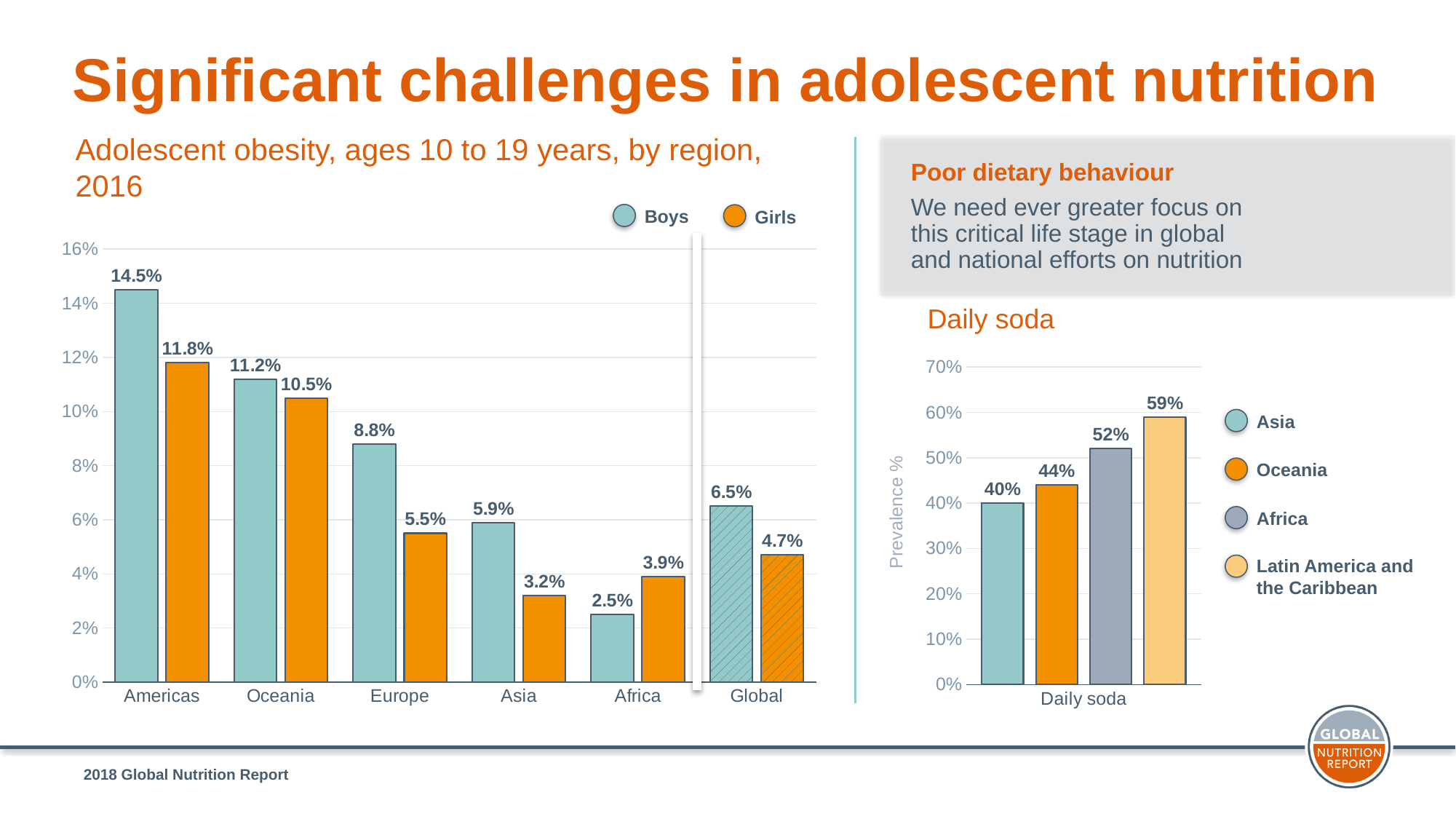
In the 'Adolescent obesity, ages 10 to 19 years, by region, 2016' chart, which is larger in Africa, Boys or Girls? Girls In the 'Adolescent obesity, ages 10 to 19 years, by region, 2016' chart, what is the value for Girls in Europe? 5.5% In the 'Adolescent obesity, ages 10 to 19 years, by region, 2016' chart, which region has the highest value for Girls? Americas In the 'Adolescent obesity, ages 10 to 19 years, by region, 2016' chart, what is the value for Boys in the Americas? 14.5% In the 'Daily soda' chart, what is the difference between Latin America and the Caribbean and Asia? 19% In the 'Adolescent obesity, ages 10 to 19 years, by region, 2016' chart, how many regions are shown on the x axis? 6 In the 'Adolescent obesity, ages 10 to 19 years, by region, 2016' chart, what is the difference between Boys and Girls in Oceania? 0.7% In the 'Adolescent obesity, ages 10 to 19 years, by region, 2016' chart, which region has the lowest value for Boys? Africa In the 'Daily soda' chart, which region has the highest prevalence? Latin America and the Caribbean In the 'Adolescent obesity, ages 10 to 19 years, by region, 2016' chart, how many series does the legend list? 2 In the 'Daily soda' chart, what is the value for Africa? 52% What kind of chart is the 'Daily soda' chart? Bar chart